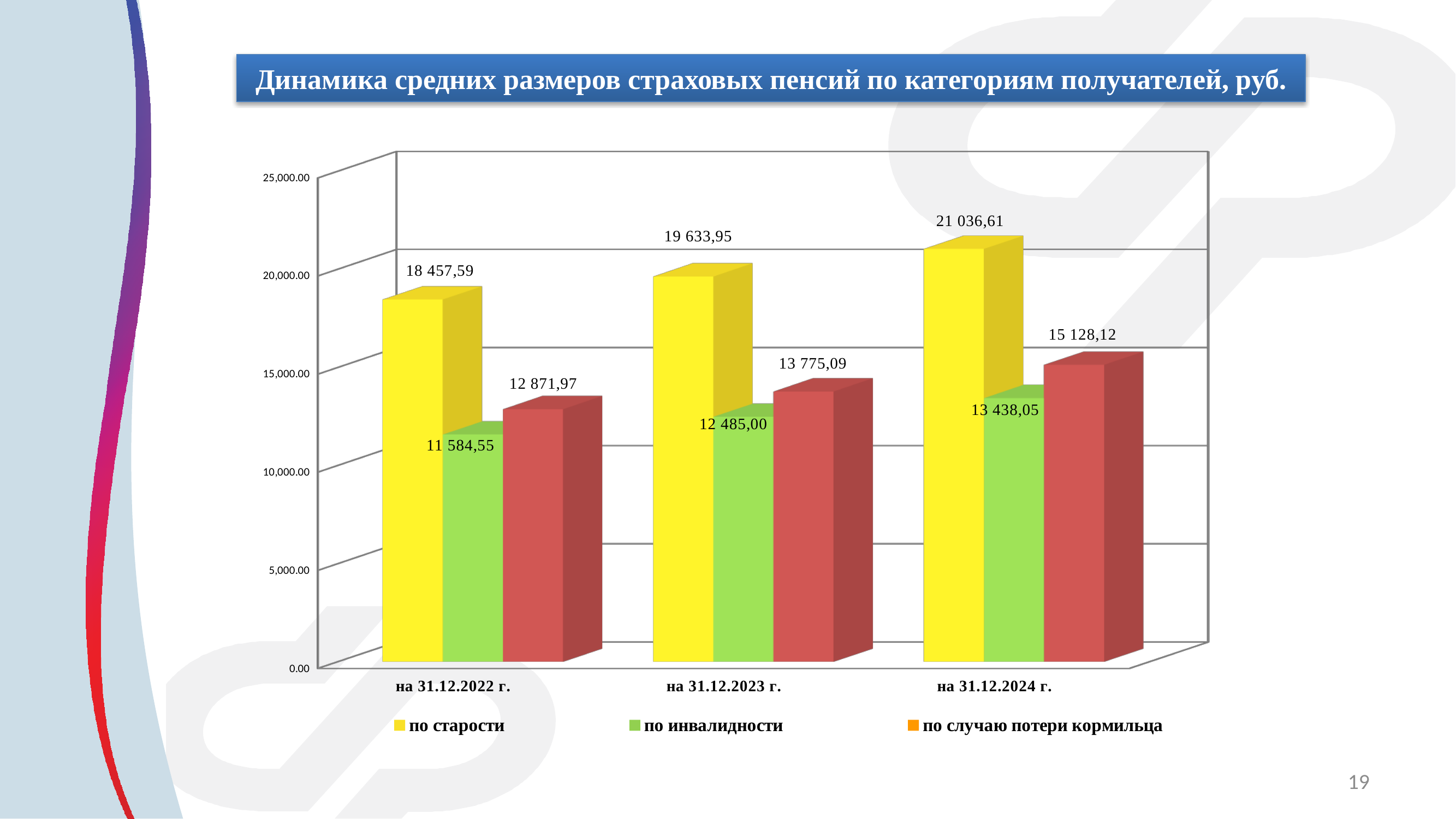
Does the value for «по случаю потери кормильца» rise or fall from 31.12.2022 to 31.12.2024? rise How many series does the legend list? 3 Which is larger on 31.12.2023: «по инвалидности» or «по случаю потери кормильца»? по случаю потери кормильца What is the difference between the «по старости» values on 31.12.2024 and 31.12.2022? 2 579,02 In which period is the value for «по инвалидности» the lowest? на 31.12.2022 г. In which period is the value for «по старости» the highest? на 31.12.2024 г. What is the value for «по случаю потери кормильца» on 31.12.2022? 12 871,97 Is the value for «по старости» on 31.12.2024 greater or less than 20,000.00? greater What is the value for «по инвалидности» on 31.12.2023? 12 485,00 How many periods (categories) are shown on the x axis? 3 What is the value for «по старости» on 31.12.2022? 18 457,59 What is the value for «по случаю потери кормильца» on 31.12.2024? 15 128,12